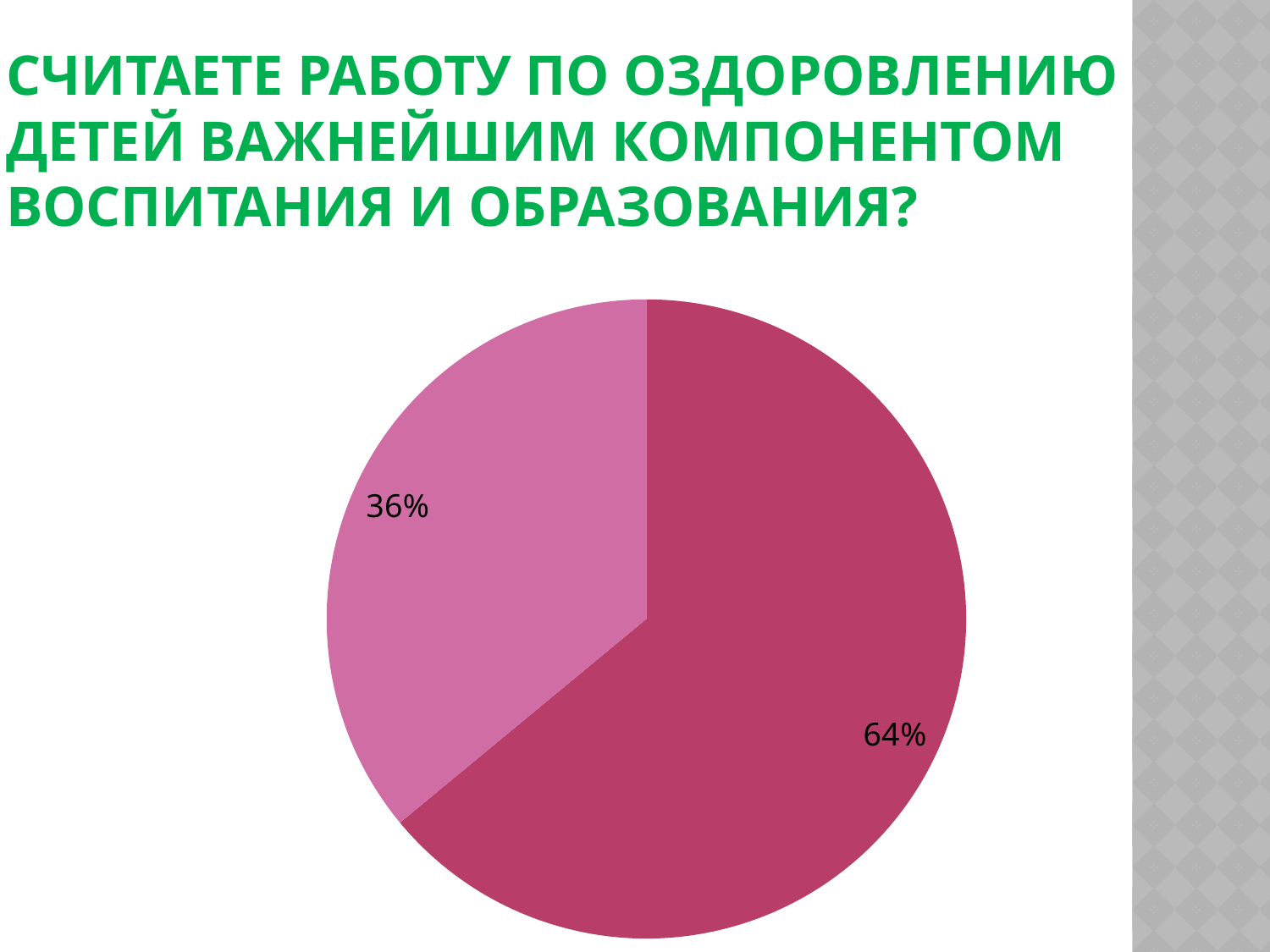
What is the largest value shown in the pie chart? 64% Is the value of the lighter pink slice greater or less than 50%? less What percentage is labelled on the darker magenta slice of the pie chart? 64% Which slice is larger, the darker magenta one or the lighter pink one? the darker magenta one What percentage is labelled on the lighter pink slice of the pie chart? 36% What is the smallest value shown in the pie chart? 36% How many slices does the pie chart have? 2 What is the value shown on the larger slice of the pie chart? 64% What is the difference between the two slices of the pie chart? 28% What is the value shown on the smaller slice of the pie chart? 36% Does the pie chart include a legend? No What kind of chart is shown on the slide? pie chart